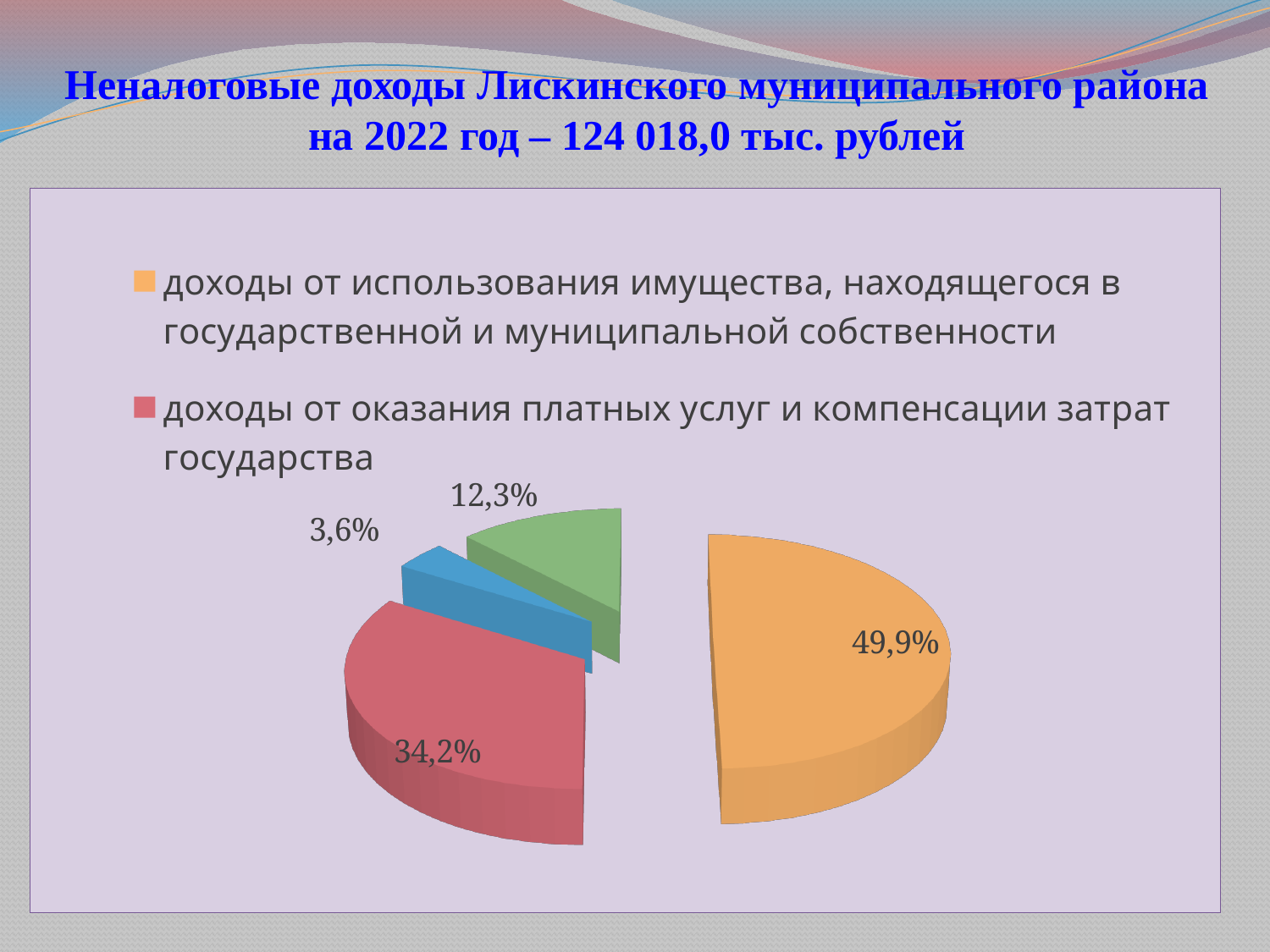
Which legend category has the largest slice of the pie? доходы от использования имущества, находящегося в государственной и муниципальной собственности What is the value of the green slice of the pie? 12,3% What is the value of the largest slice in the pie chart? 49,9% What share of the pie is labelled for income from the use of state and municipal property (доходы от использования имущества)? 49,9% Which is larger: the slice for income from use of property or the slice for paid services and compensation of state costs? доходы от использования имущества, находящегося в государственной и муниципальной собственности What total amount of non-tax revenue for 2022 is stated in the slide title? 124 018,0 тыс. рублей How many slices does the pie chart have? 4 What is the difference in percentage points between the slice for income from use of property (49,9%) and the slice for paid services (34,2%)? 15,7 What share of the pie is labelled for income from paid services and compensation of state costs (доходы от оказания платных услуг)? 34,2% How many entries does the legend list? 2 What is the value of the smallest slice in the pie chart? 3,6% What kind of chart is shown on the slide? pie chart